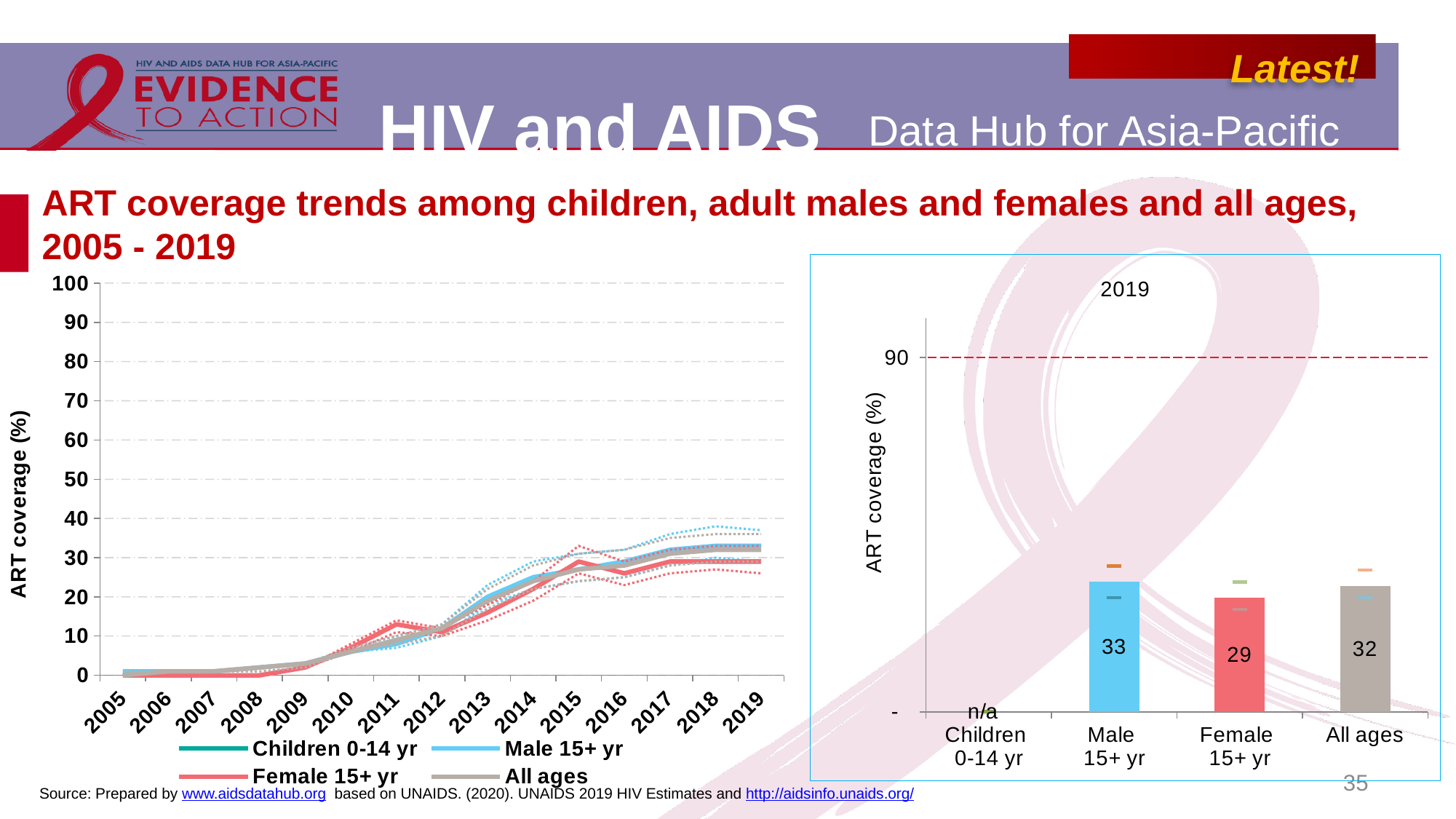
How many series does the legend of the left line chart list? 4 In the bar chart on the right (2019), what value does the red dashed reference line mark? 90 In the bar chart on the right (2019), what is shown for Children 0-14 yr? n/a What kind of chart is the chart on the left of the slide? Line chart In the left line chart, is the value for Male 15+ yr in 2019 greater or less than 20? greater In the bar chart on the right (2019), which category has the highest ART coverage? Male 15+ yr In the bar chart on the right (2019), which is larger, the value for Female 15+ yr or All ages? All ages In the bar chart on the right (2019), what is the difference between the Male 15+ yr and Female 15+ yr values? 4 In the bar chart on the right (2019), what is the ART coverage value for All ages? 32 In the bar chart on the right (2019), what is the ART coverage value for Female 15+ yr? 29 In the bar chart on the right (2019), what is the ART coverage value for Male 15+ yr? 33 In the left line chart, does ART coverage for All ages rise or fall from 2005 to 2019? Rise